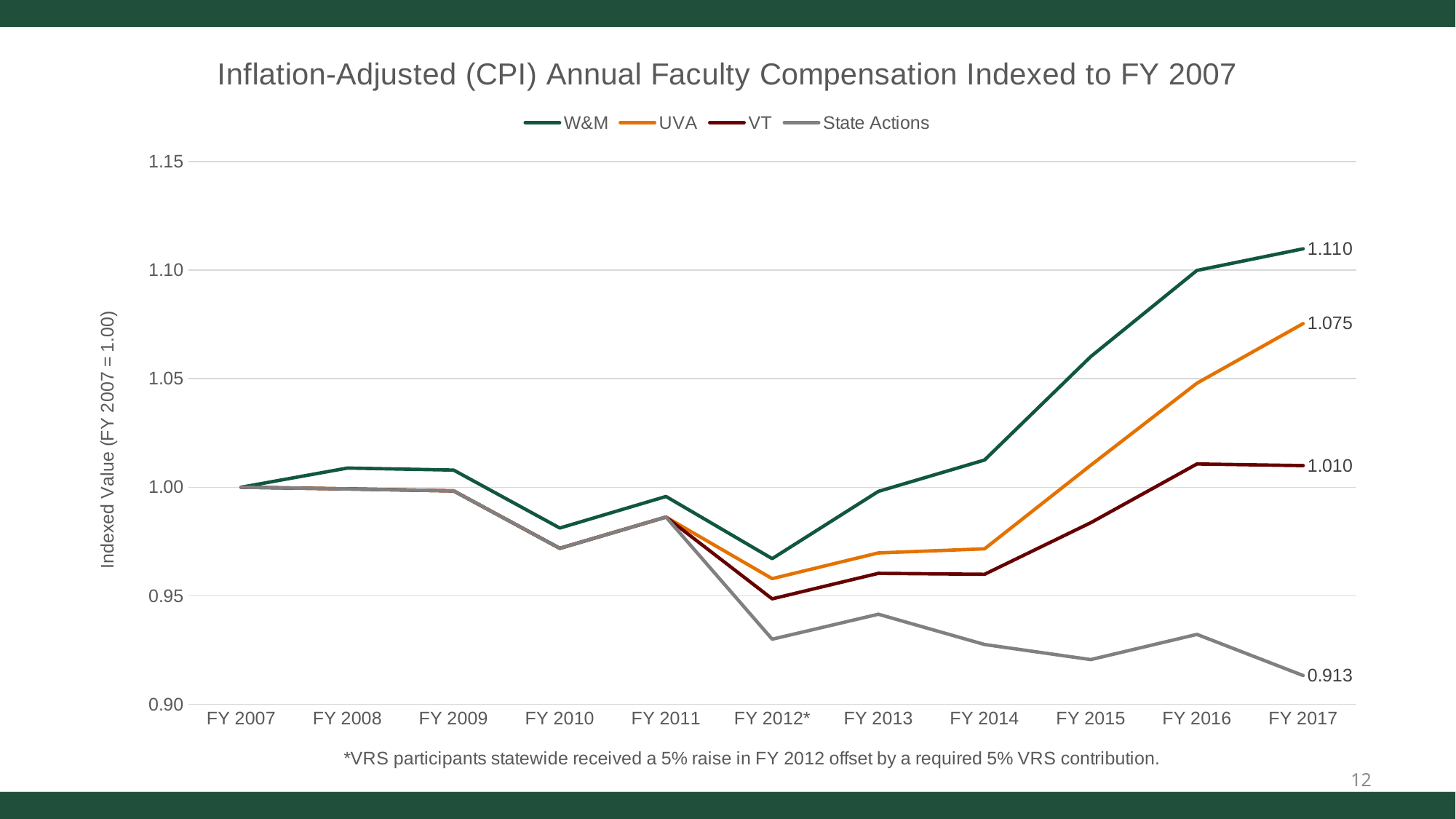
Which series has the highest value in FY 2017? W&M What is the difference between the W&M and UVA values in FY 2017? 0.035 What is the value for VT in FY 2017? 1.010 What is the value for W&M in FY 2017? 1.110 What is the value for State Actions in FY 2017? 0.913 How many fiscal years are shown on the x axis? 11 How many series does the legend list? 4 What kind of chart is shown on the slide? Line chart Which series has the lowest value in FY 2017? State Actions Is the value for State Actions in FY 2012* greater or less than 0.95? less Which is larger in FY 2017, the VT value or the State Actions value? VT What is the value for UVA in FY 2017? 1.075